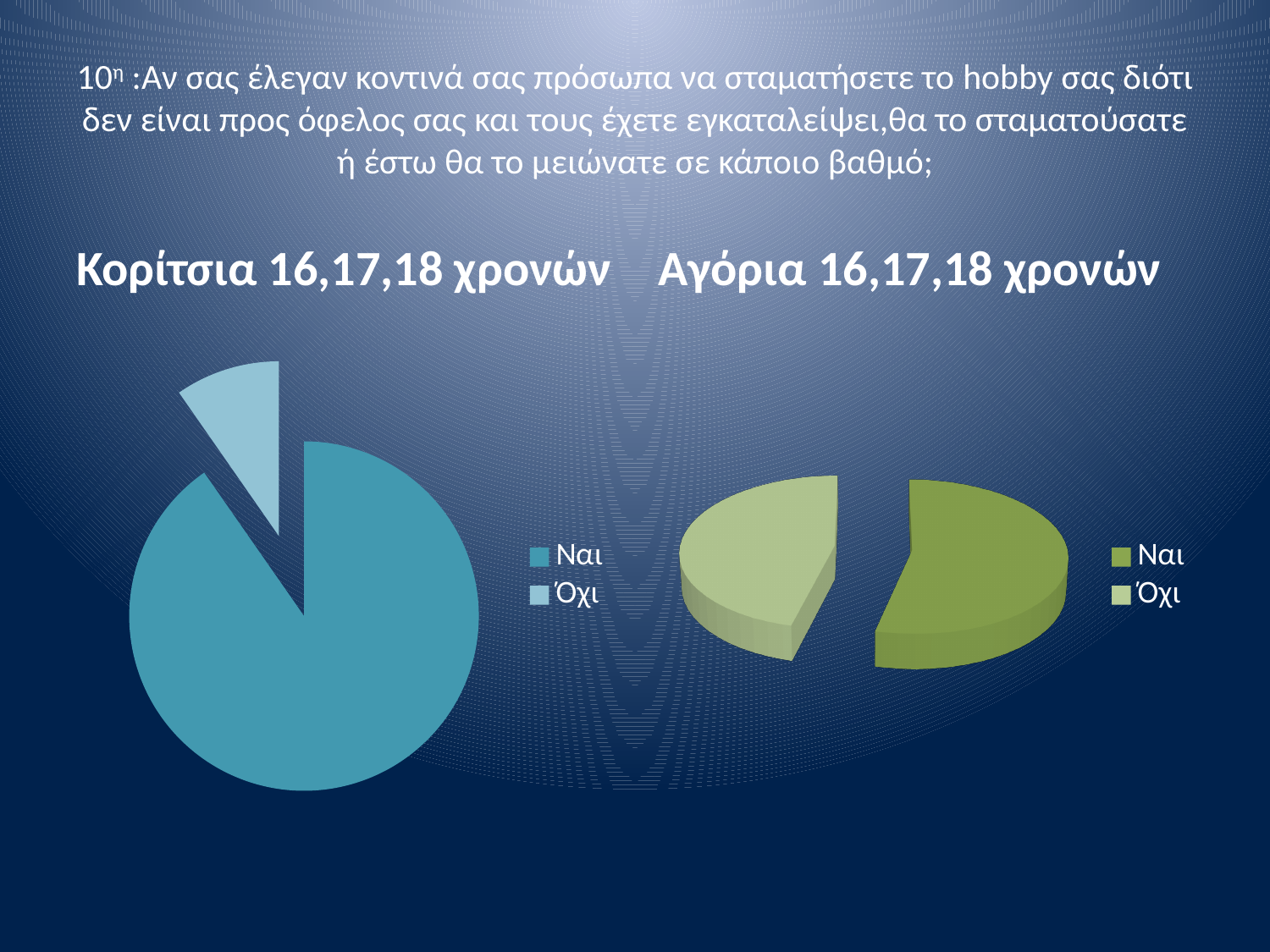
In the "Κορίτσια 16,17,18 χρονών" chart, which slice is larger, Ναι or Όχι? Ναι What kind of chart is the "Κορίτσια 16,17,18 χρονών" chart? pie chart In the "Κορίτσια 16,17,18 χρονών" chart, which category has the smallest slice? Όχι In the "Κορίτσια 16,17,18 χρονών" chart, which category has the largest slice? Ναι How many pie charts are shown on the slide? 2 How many entries does the legend of the "Κορίτσια 16,17,18 χρονών" chart list? 2 What kind of chart is the "Αγόρια 16,17,18 χρονών" chart? pie chart What are the two legend entries of the "Αγόρια 16,17,18 χρονών" chart? Ναι, Όχι How many slices does the "Κορίτσια 16,17,18 χρονών" pie chart have? 2 What is the title of the pie chart on the right side of the slide? Αγόρια 16,17,18 χρονών How many slices does the "Αγόρια 16,17,18 χρονών" pie chart have? 2